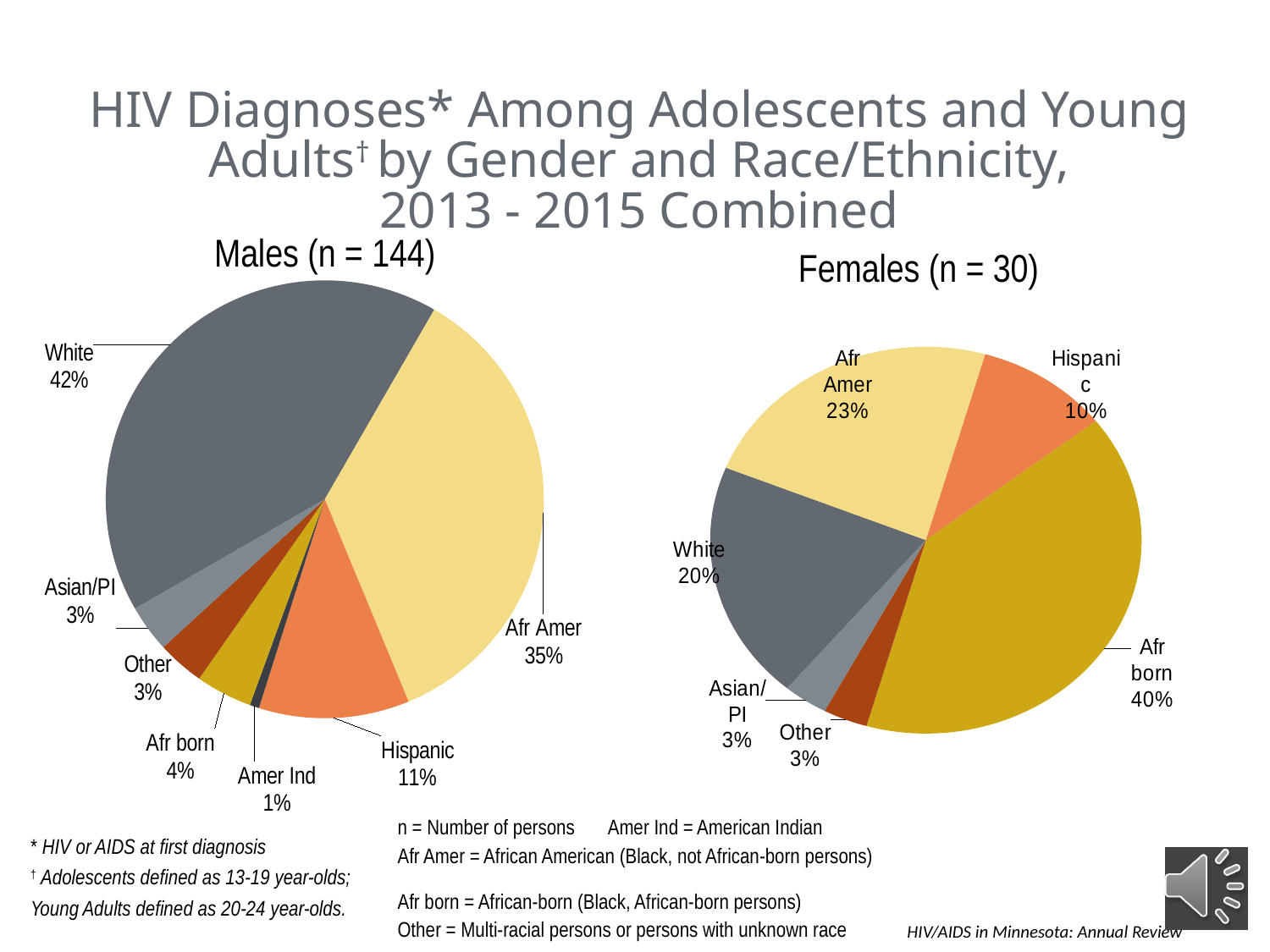
In the Males (n = 144) chart, what share of HIV diagnoses is White? 42% In the Males (n = 144) chart, which race/ethnicity has the largest share? White In the Males (n = 144) chart, what is the difference between the White share and the Afr Amer share? 7% What type of chart is used for the Males (n = 144) data? Pie chart Which is larger: the Hispanic share in the Males chart or the Hispanic share in the Females chart? Males In the Females (n = 30) chart, what share is Afr Amer? 23% In the Females (n = 30) chart, what is the difference between the Afr born share and the White share? 20% In the Females (n = 30) chart, which race/ethnicity has the largest share? Afr born How many race/ethnicity slices does the Females (n = 30) chart have? 6 In the Females (n = 30) chart, what share of HIV diagnoses is Afr born? 40% In the Males (n = 144) chart, what share is Hispanic? 11% In the Males (n = 144) chart, which race/ethnicity has the smallest share? Amer Ind